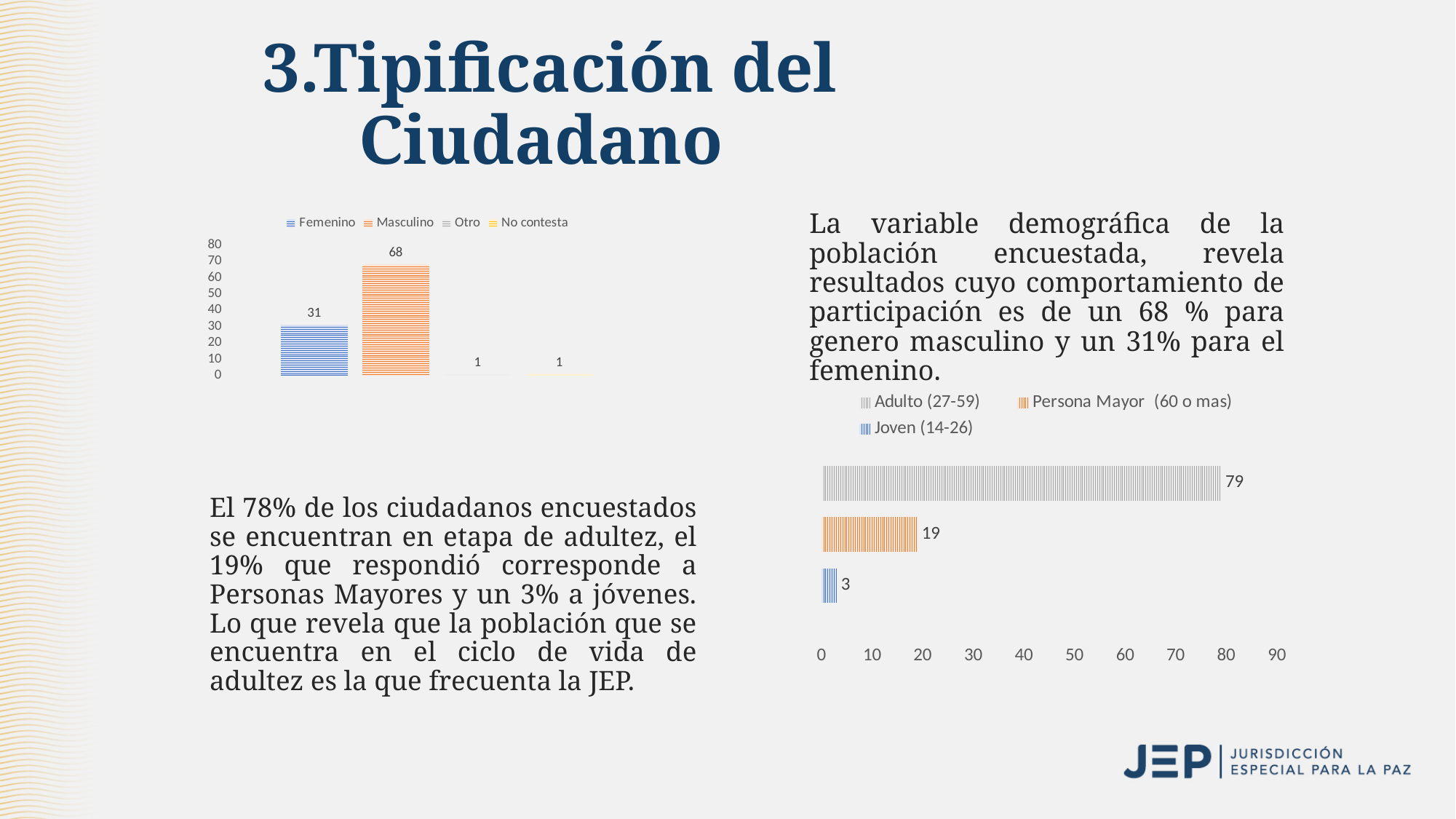
In the bar chart on the right of the slide, what is the value for Joven (14-26)? 3 In the bar chart on the right of the slide, what is the value for Adulto (27-59)? 79 In the bar chart on the right of the slide, which category has the lowest value? Joven (14-26) What kind of chart is shown on the right of the slide? Bar chart In the bar chart on the right of the slide, what is the difference between Adulto (27-59) and Persona Mayor (60 o mas)? 60 In the bar chart on the left of the slide, what is the value for Otro? 1 In the bar chart on the left of the slide, which category has the highest value? Masculino In the bar chart on the right of the slide, how many bars are plotted? 3 In the bar chart on the left of the slide, what is the difference between the Masculino and Femenino values? 37 In the bar chart on the left of the slide, what is the value for Masculino? 68 In the bar chart on the left of the slide, what is the value for Femenino? 31 In the bar chart on the left of the slide, how many entries does the legend list? 4